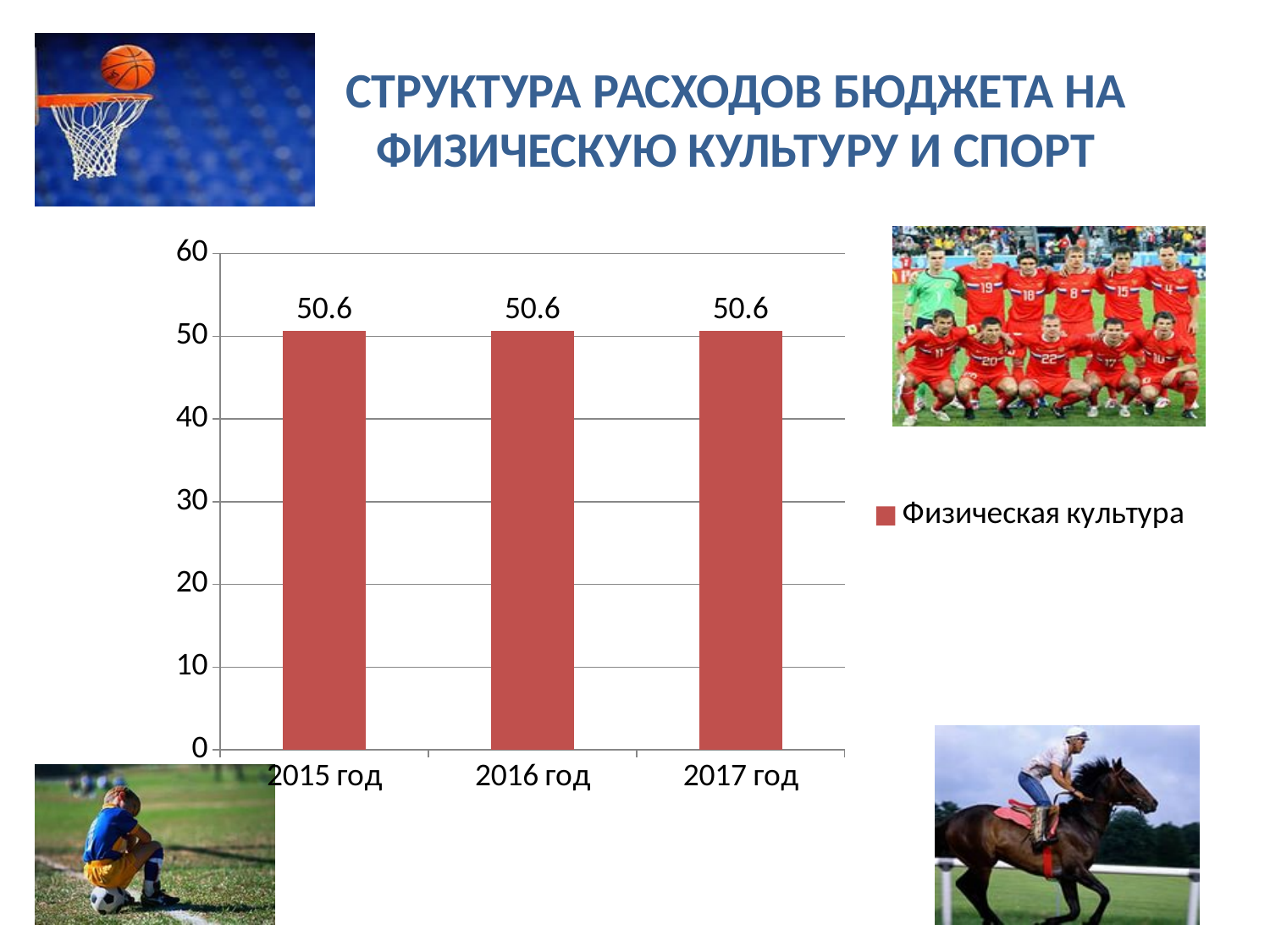
What is the highest value shown on the vertical axis? 60 What is the value for 2015 год? 50.6 What is the difference between the values for 2015 год and 2017 год? 0 How many categories are shown on the x axis? 3 What kind of chart is shown on the slide? bar chart Do the values rise, fall or stay the same from 2015 год to 2017 год? stay the same What series name is listed in the legend? Физическая культура Is the value for 2016 год greater or less than 40? greater Is the value for 2017 год greater or less than 60? less What is the value for 2016 год? 50.6 How many series does the legend list? 1 What is the value for 2017 год? 50.6